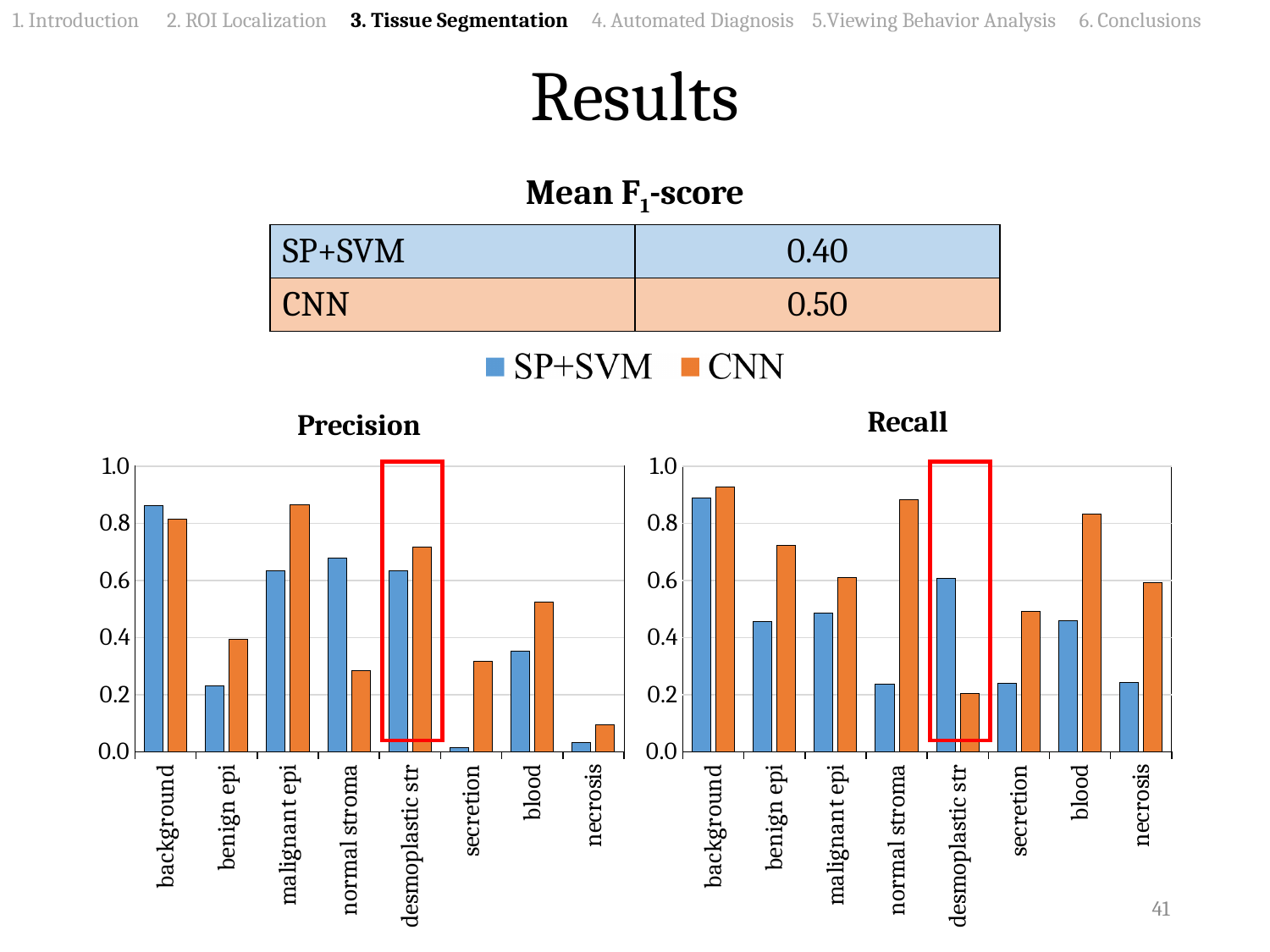
How many series does the legend list for the Precision and Recall charts? 2 How many tissue categories are shown on the x axis of the Recall chart? 8 In the Precision chart, is the CNN value for secretion greater or less than 0.4? less In the Recall chart, is the CNN value for normal stroma greater or less than 0.8? greater In the Recall chart, for desmoplastic str, which series has the larger value, SP+SVM or CNN? SP+SVM In the Recall chart, which category has the highest SP+SVM value? background In the Precision chart, which category has the lowest CNN value? necrosis Which colour represents the CNN series in the charts? orange What type of chart is the Precision chart? bar chart In the Recall chart, which category has the lowest CNN value? desmoplastic str In the Precision chart, for normal stroma, which series has the larger value, SP+SVM or CNN? SP+SVM In the Precision chart, which category has the highest SP+SVM value? background